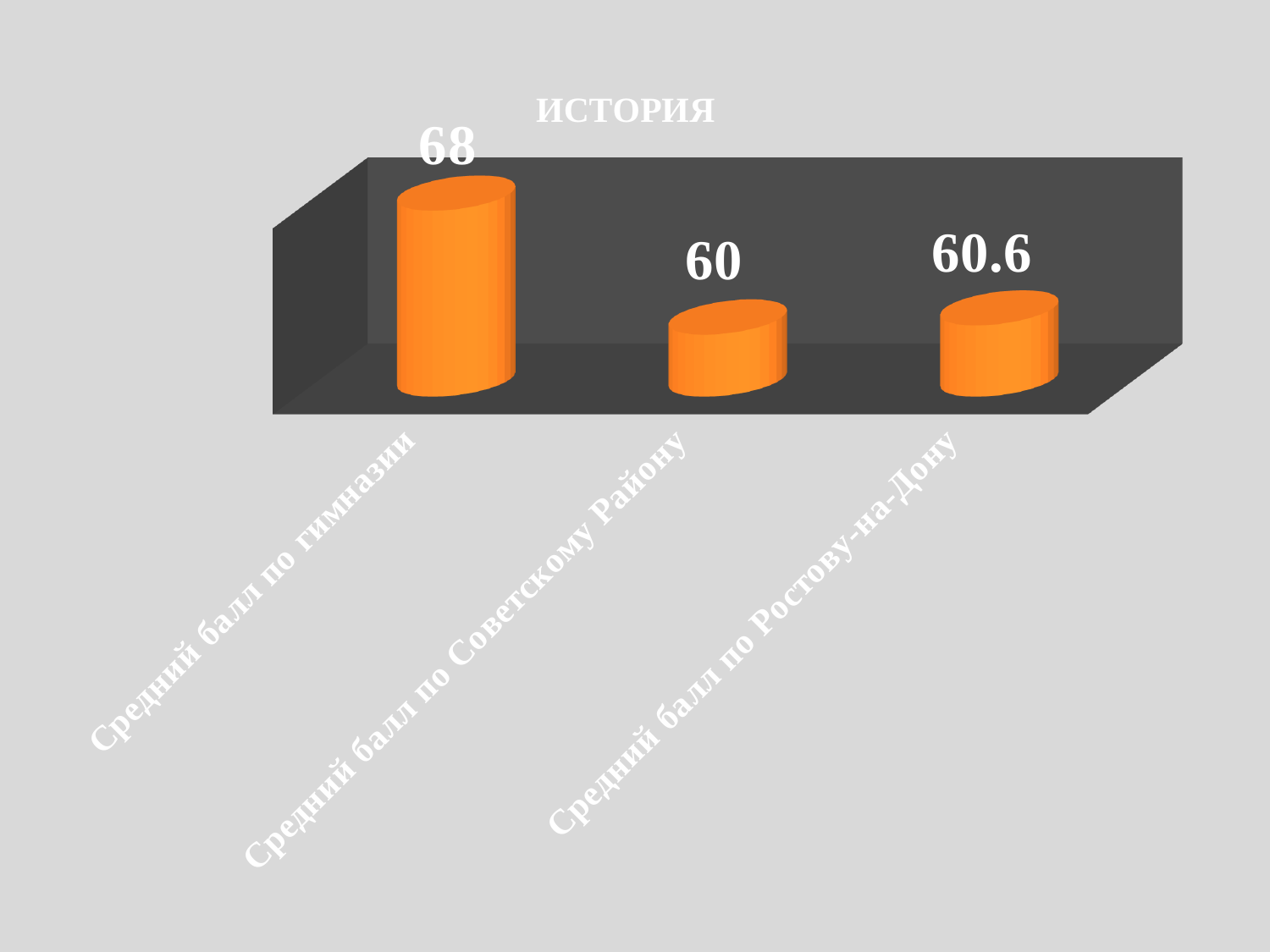
What is the value for Средний балл по Советскому Району? 60 Which is larger: the value for Средний балл по гимназии or the value for Средний балл по Ростову-на-Дону? Средний балл по гимназии What is the value for Средний балл по Ростову-на-Дону? 60.6 What kind of chart is shown on the slide? bar chart What is the title of the chart? ИСТОРИЯ What is the difference between the value for Средний балл по Ростову-на-Дону and the value for Средний балл по Советскому Району? 0.6 What is the difference between the value for Средний балл по гимназии and the value for Средний балл по Советскому Району? 8 What colour are the bars in the chart? orange What is the value for Средний балл по гимназии? 68 How many categories are shown in the chart? 3 Which category has the highest value? Средний балл по гимназии Which category has the lowest value? Средний балл по Советскому Району